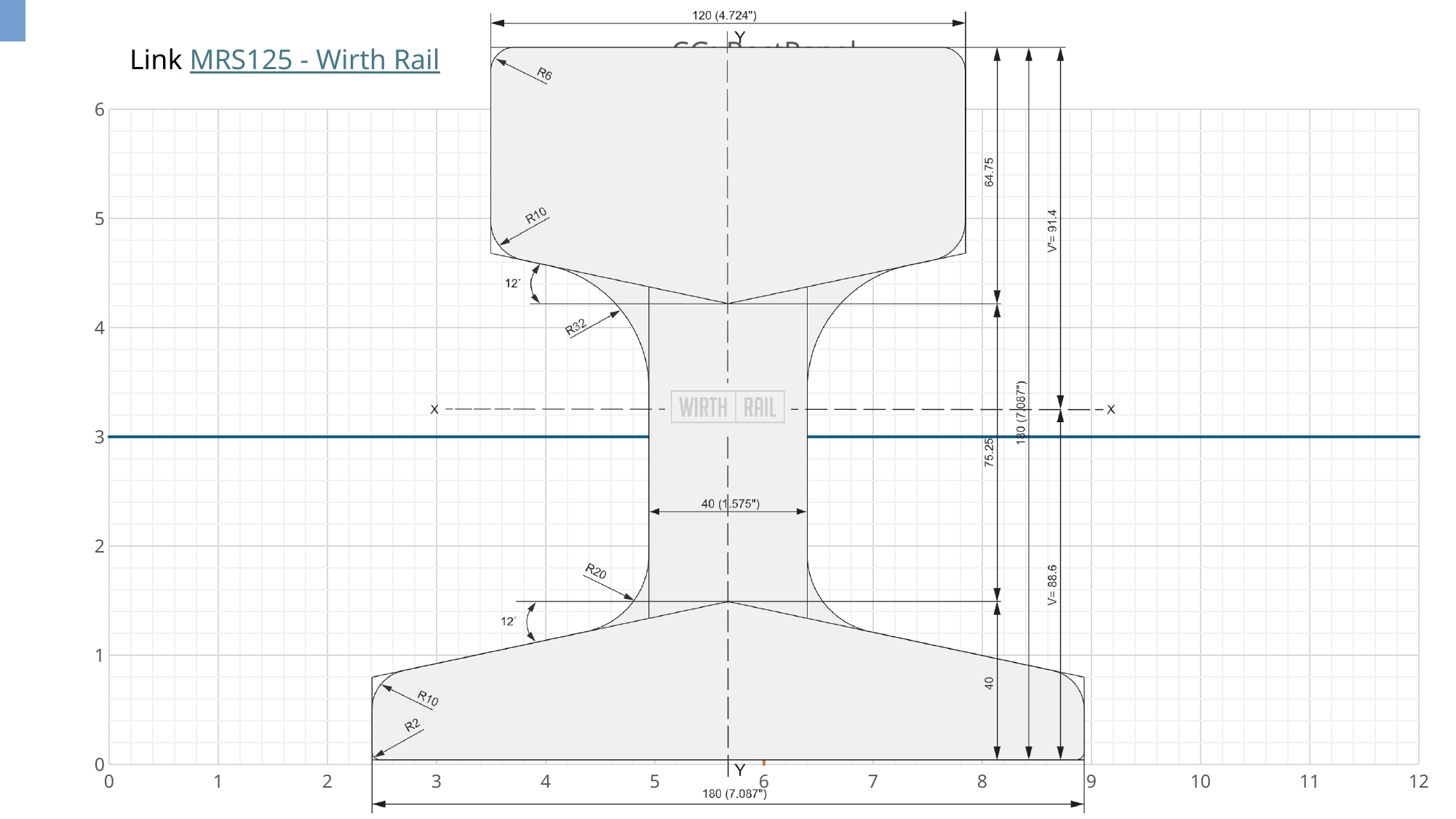
Is the value of the horizontal blue line greater or less than 2? greater What kind of chart is shown on the slide? line chart What is the web width dimension printed in the middle of the rail drawing? 40 (1.575") What is the highest value labelled on the y axis? 6 What is the width dimension printed at the top of the rail head in the overlaid drawing? 120 (4.724") Does the blue line rise, fall, or stay flat along the x axis? stays flat At what y-axis value is the horizontal blue line plotted? 3 What is the width dimension printed at the bottom of the rail base in the overlaid drawing? 180 (7.087") Is the value of the horizontal blue line greater or less than 4? less What is the highest value labelled on the x axis? 12